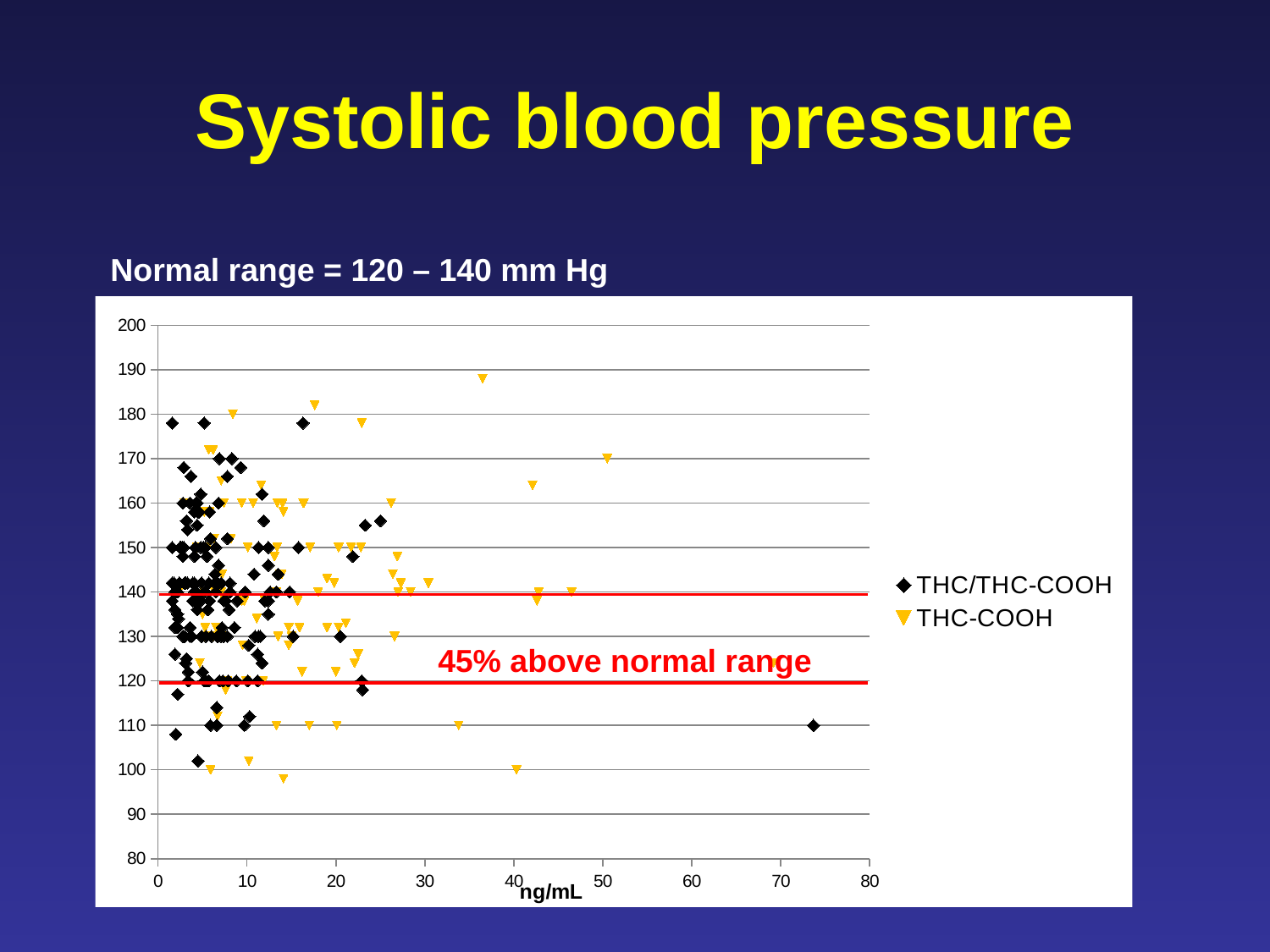
Is the THC/THC-COOH point with the largest ng/mL value greater or less than 120 on the y axis? less Is the lowest THC-COOH value on the chart greater or less than 110? less What is the label on the x axis of the chart? ng/mL Which series contains the highest systolic blood pressure value plotted? THC-COOH Is the highest THC-COOH value on the chart greater or less than 190? less How many series does the legend list? 2 What kind of chart is shown on the slide? Scatter plot What are the two series named in the legend? THC/THC-COOH and THC-COOH Which series contains the point with the largest ng/mL value? THC/THC-COOH